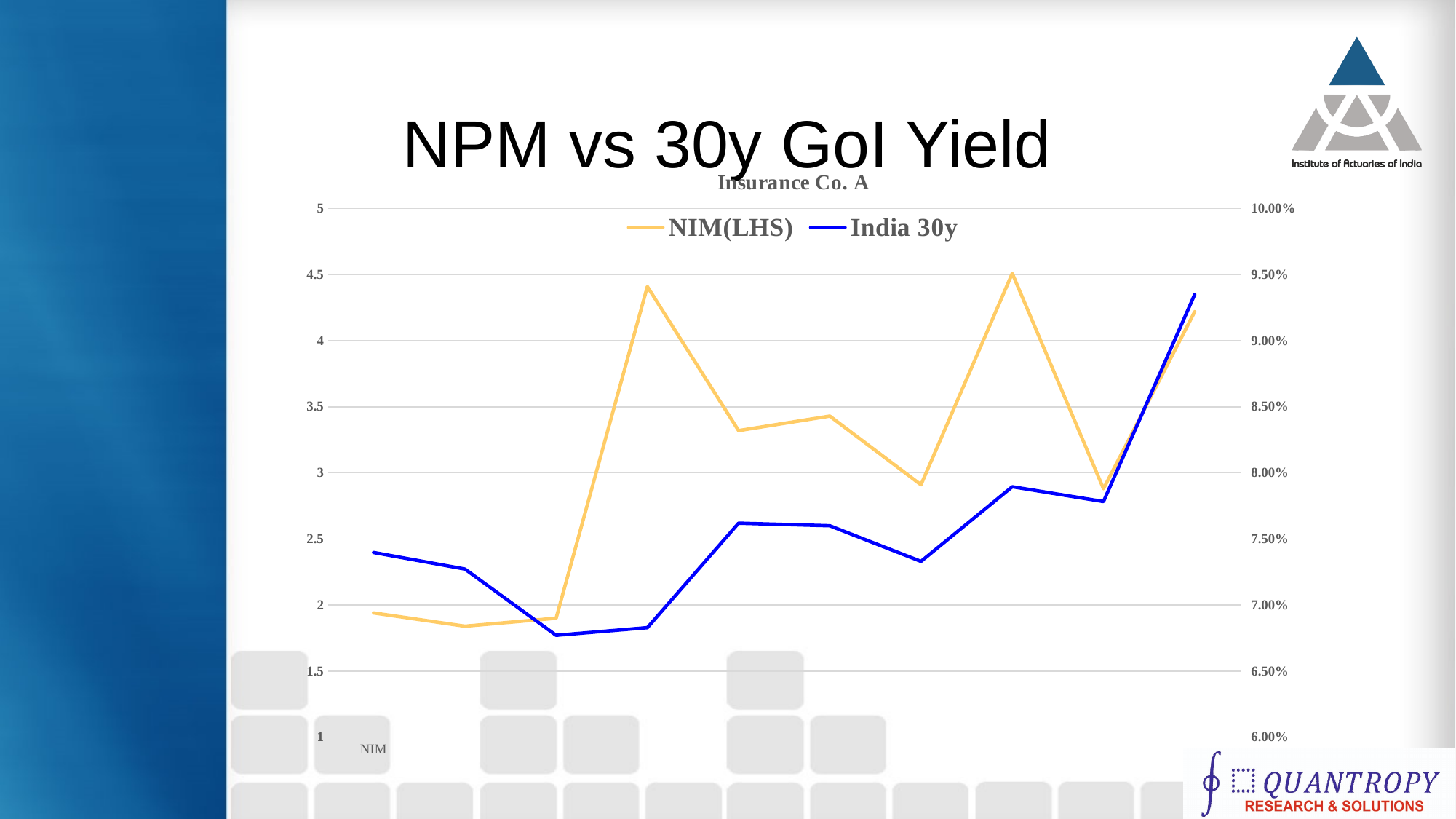
Is the last (rightmost) value of the NIM(LHS) line greater or less than 4? greater What are the two series named in the legend? NIM(LHS) and India 30y What colour is the line for the India 30y series? blue Overall, does the NIM(LHS) line rise or fall from its first point to its last point? rise Is the last (rightmost) value of the India 30y line greater or less than 9.00%? greater Is the first (leftmost) value of the NIM(LHS) line greater or less than 2? less How many series does the legend list? 2 How many data points does the NIM(LHS) line have? 10 Overall, does the India 30y line rise or fall from left to right? rise What kind of chart is shown on the slide? line chart